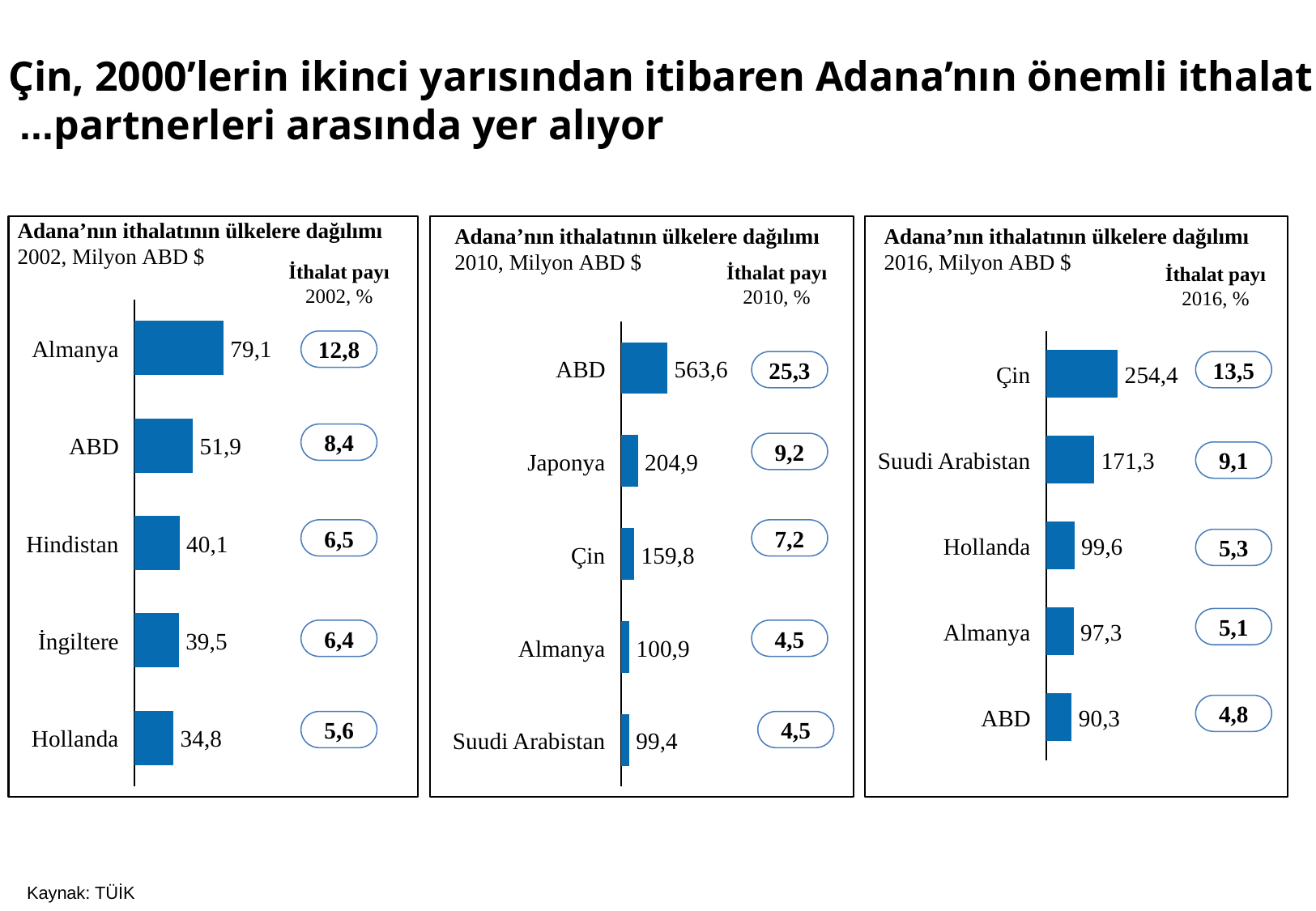
In the 2002 chart (left), what is the import value for Almanya? 79,1 In the 2016 chart (right), which country has the lowest import value? ABD What unit is stated in the subtitle of the 2002 chart (left)? Milyon ABD $ In the 2010 chart (middle), what is the difference between the import values of ABD and Çin? 403,8 In the 2016 chart (right), what is the import value for Çin? 254,4 In the 2016 chart (right), which is larger, the import value for Hollanda or for Almanya? Hollanda In the 2010 chart (middle), which country has the highest import value? ABD In the 2010 chart (middle), what is the import value for Japonya? 204,9 How many countries are shown in the 2010 chart (middle)? 5 In the 2002 chart (left), what is the difference between the import values of Almanya and Hollanda? 44,3 What type of chart is used in the 2002 chart (left)? Bar chart In the 2016 chart (right), what is the import share (İthalat payı) for Suudi Arabistan? 9,1